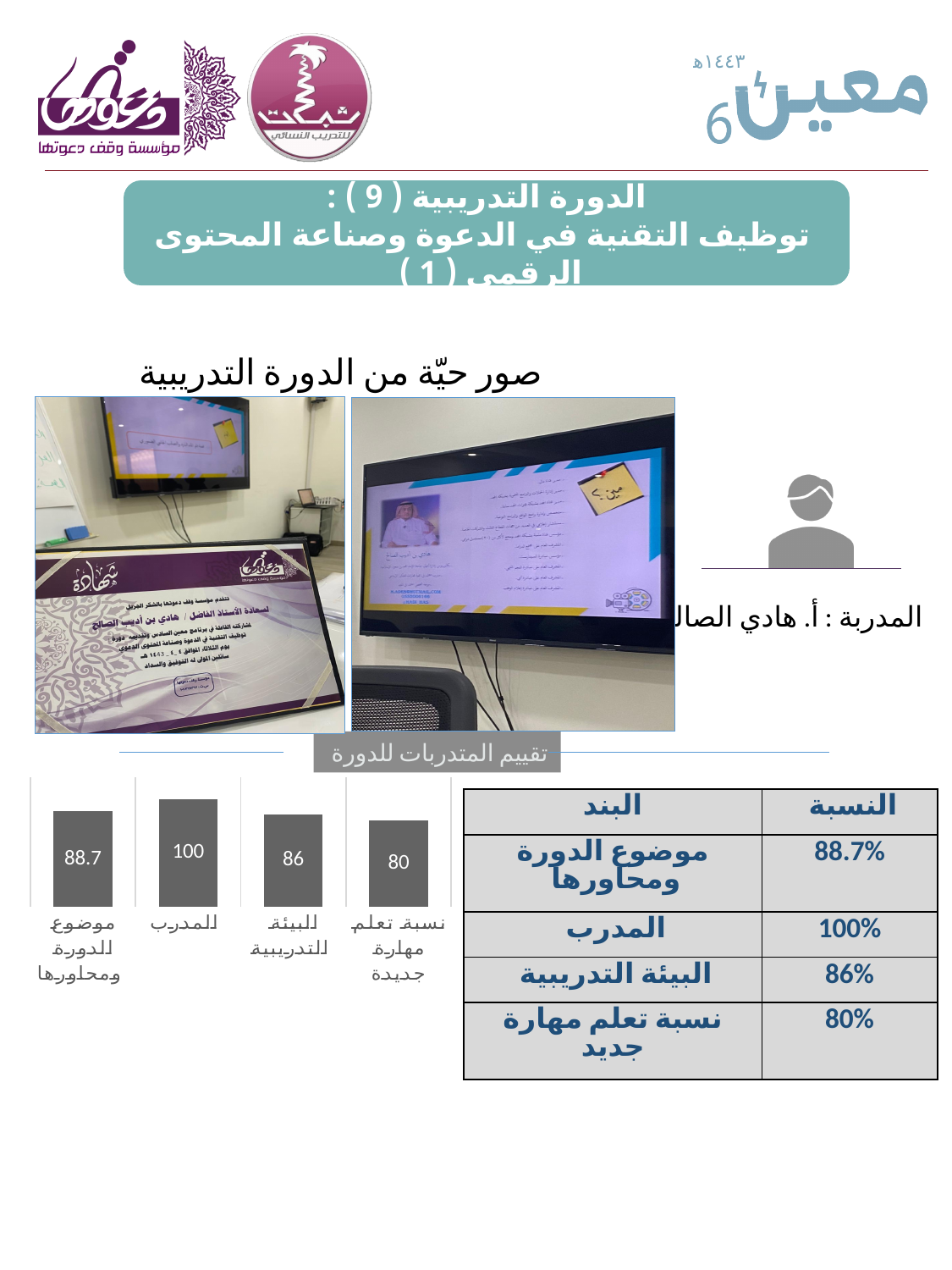
What type of chart is shown under the heading تقييم المتدربات للدورة? Bar chart In the chart تقييم المتدربات للدورة, what is the value for البيئة التدريبية? 86 How many bars does the chart تقييم المتدربات للدورة have? 4 In the chart تقييم المتدربات للدورة, which category has the lowest value? نسبة تعلم مهارة جديدة In the chart تقييم المتدربات للدورة, what is the difference between the values for المدرب and نسبة تعلم مهارة جديدة? 20 In the chart تقييم المتدربات للدورة, what is the value for موضوع الدورة ومحاورها? 88.7 In the chart تقييم المتدربات للدورة, what is the value for المدرب? 100 In the chart تقييم المتدربات للدورة, what is the value for نسبة تعلم مهارة جديدة? 80 In the chart تقييم المتدربات للدورة, which is larger: the value for البيئة التدريبية or the value for نسبة تعلم مهارة جديدة? البيئة التدريبية In the chart تقييم المتدربات للدورة, which category has the highest value? المدرب In the chart تقييم المتدربات للدورة, what is the difference between the values for موضوع الدورة ومحاورها and البيئة التدريبية? 2.7 What is the title of the bar chart on the slide? تقييم المتدربات للدورة